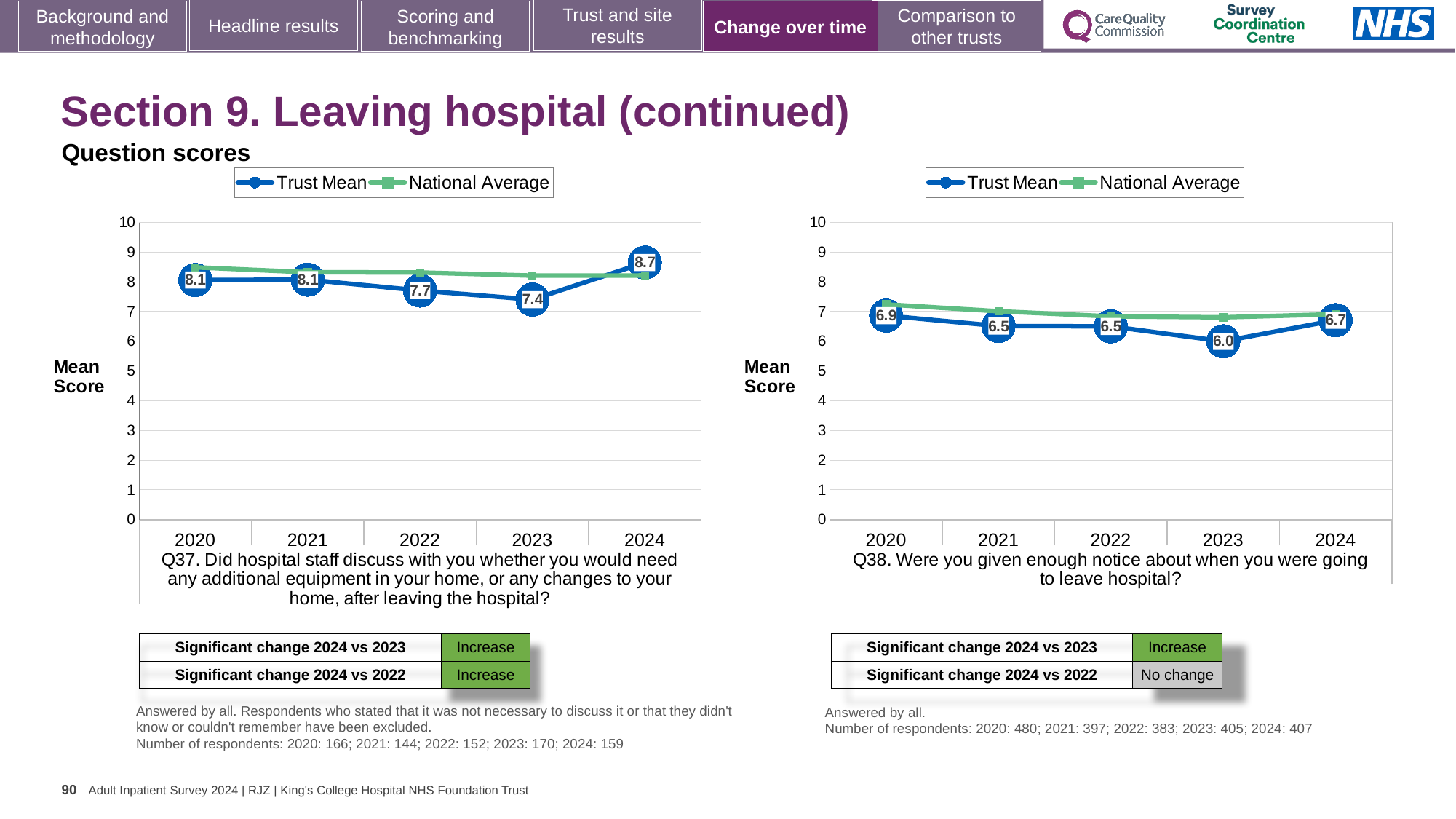
How many years are plotted on the x axis of the Q37 chart? 5 On the Q37 chart, what is the Trust Mean score for 2023? 7.4 On the Q37 chart, what is the Trust Mean score for 2024? 8.7 On the Q37 chart, which year has the lowest Trust Mean score? 2023 On the Q38 chart, is the National Average for 2020 greater or less than 7? greater What kind of chart is used for Q37? Line chart On the Q38 chart, what is the Trust Mean score for 2020? 6.9 How many series does the legend of the Q38 chart list? 2 On the Q38 chart, which year has the highest Trust Mean score? 2020 On the Q37 chart, what is the difference between the Trust Mean scores for 2024 and 2023? 1.3 On the Q38 chart, which year has the lowest Trust Mean score? 2023 On the Q38 chart, is the Trust Mean score for 2024 greater or less than the Trust Mean score for 2023? greater